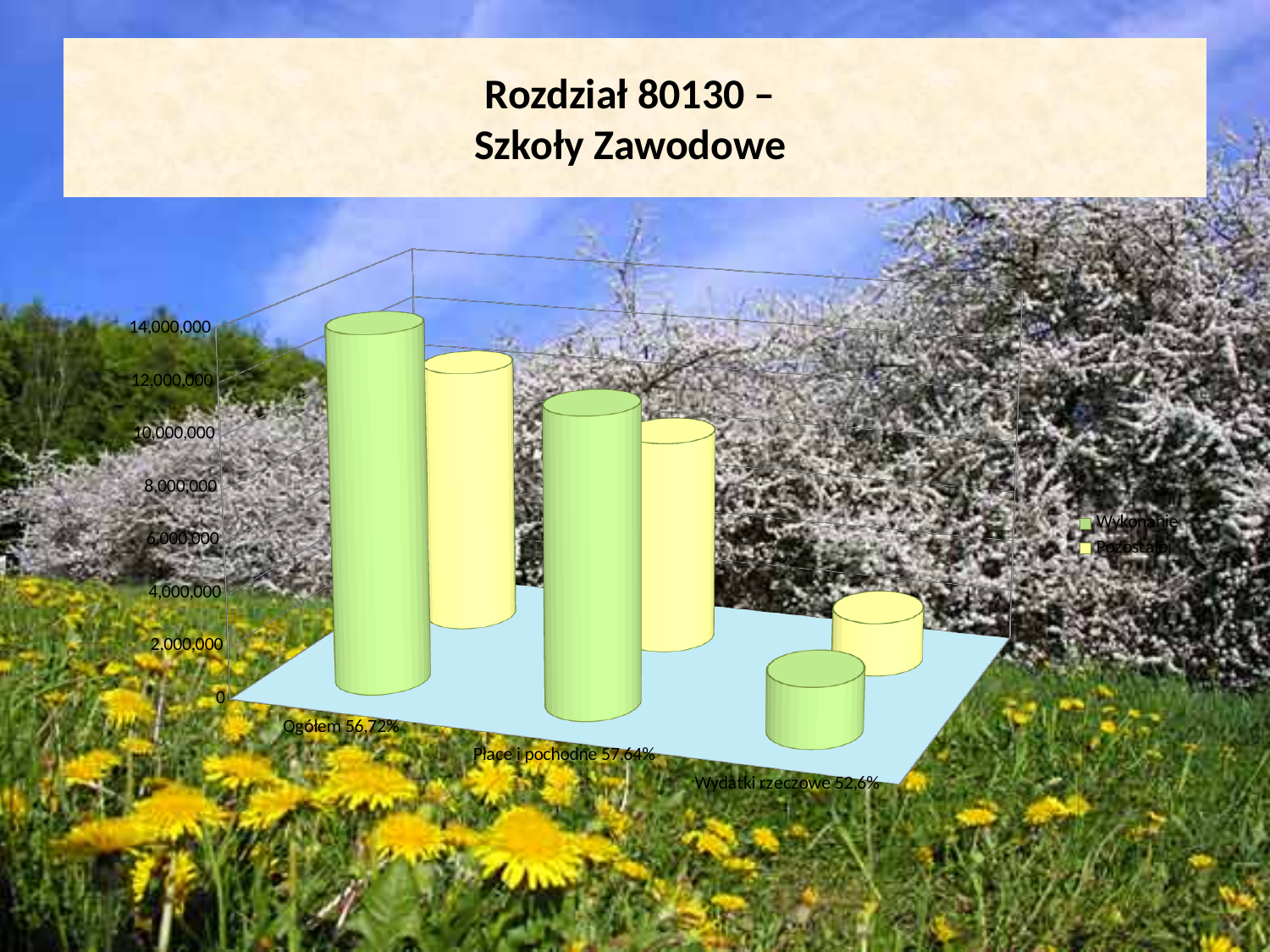
What are the two series named in the chart legend? Wykonanie and Pozostało What is the title of the slide containing the chart? Rozdział 80130 – Szkoły Zawodowe For Ogółem, which is larger: the Wykonanie bar or the Pozostało bar? Wykonanie Which category has the tallest Wykonanie bar? Ogółem 56,72% How many series does the chart legend list? 2 Is the Wykonanie value for Wydatki rzeczowe greater or less than 4,000,000? less What percentage is shown in the category label for Wydatki rzeczowe? 52,6% What kind of chart is shown on the slide? bar chart Which category has the shortest Wykonanie bar? Wydatki rzeczowe 52,6% What percentage is shown in the category label for Płace i pochodne? 57,64% Is the Wykonanie value for Ogółem greater or less than 10,000,000? greater How many categories are shown on the x axis of the chart? 3